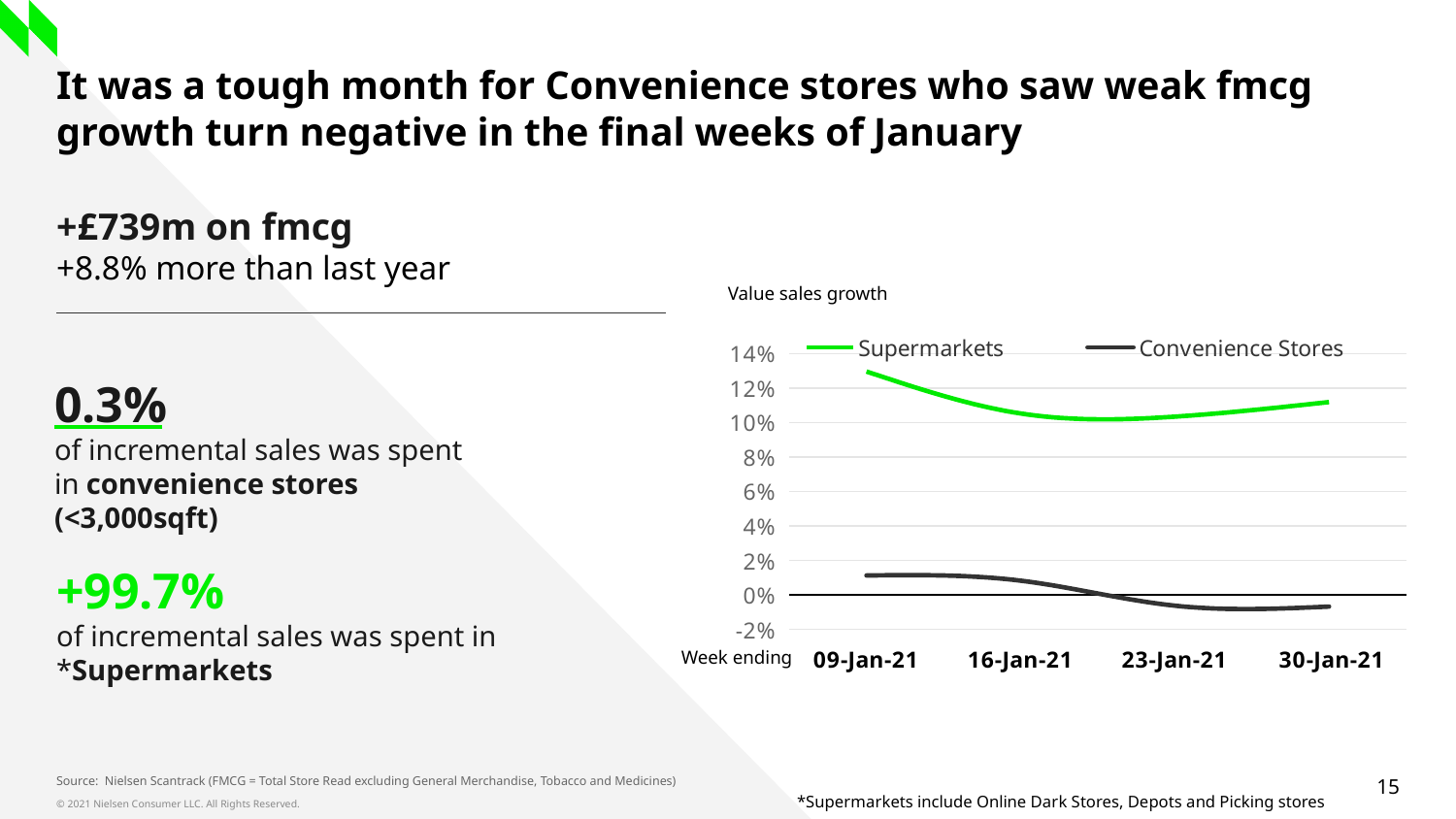
How many series does the chart legend list? 2 What is the title of the chart? Value sales growth Does the Convenience Stores series rise or fall from 09-Jan-21 to 30-Jan-21? fall Is the Convenience Stores value for week ending 30-Jan-21 greater or less than 0%? less Is the Convenience Stores value for week ending 09-Jan-21 greater or less than 2%? less What colour is the Supermarkets line? green For week ending 16-Jan-21, which series has the higher value, Supermarkets or Convenience Stores? Supermarkets Is the Supermarkets value for week ending 30-Jan-21 greater or less than 10%? greater In which week does the Supermarkets series reach its highest value? 09-Jan-21 How many week-ending dates are plotted on the x axis? 4 What kind of chart is shown on the slide? line chart